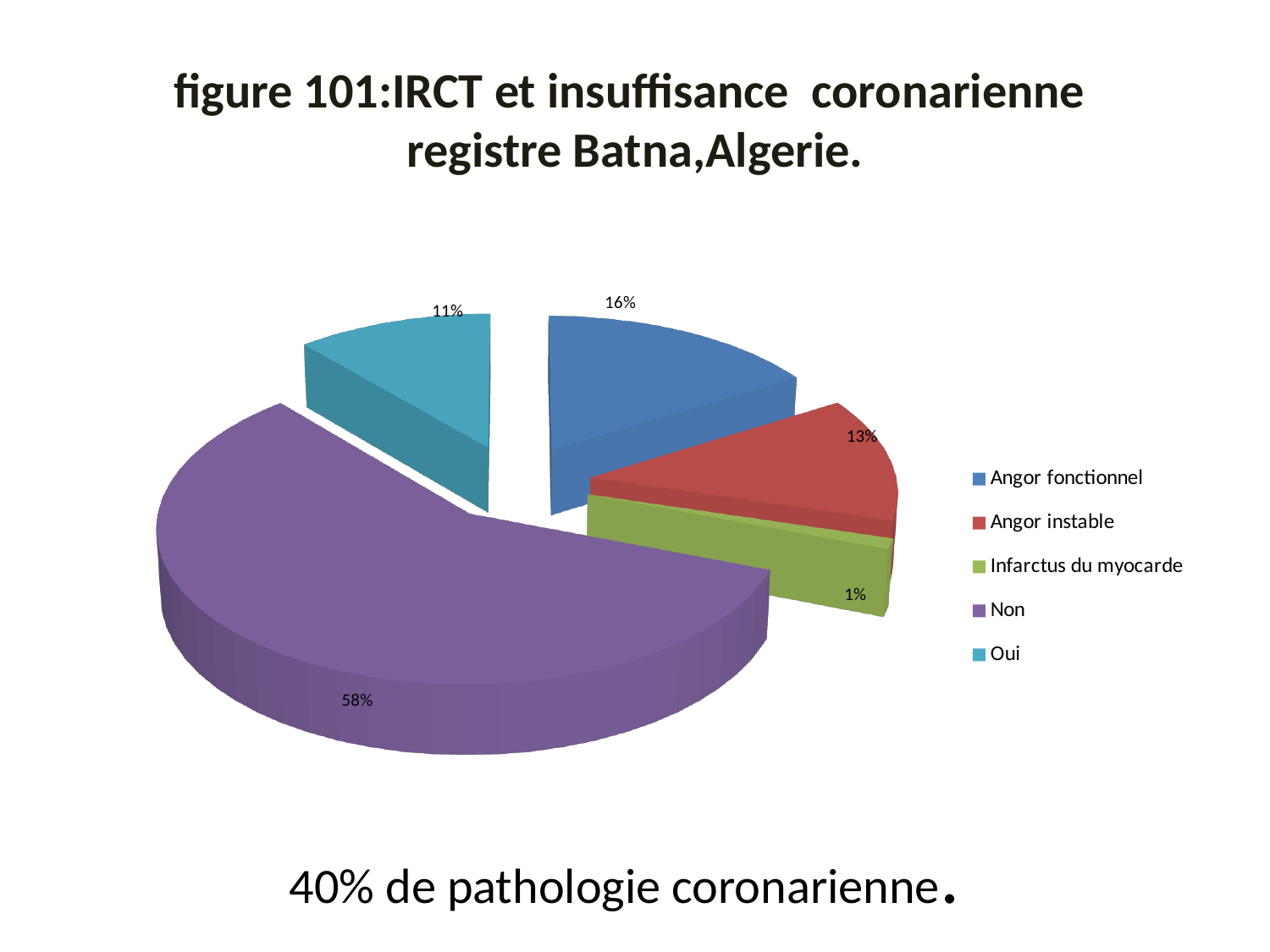
What percentage is shown for Angor instable? 13% What percentage is shown for Oui? 11% How many categories does the legend list? 5 What is the difference in percentage points between Non and Angor fonctionnel? 42 What percentage is shown for Angor fonctionnel? 16% Which category has the smallest slice of the pie? Infarctus du myocarde Which is larger, the Angor fonctionnel slice or the Oui slice? Angor fonctionnel Which category has the largest slice of the pie? Non What percentage of the pie does the Non slice represent? 58% What colour is the Non slice? Purple What percentage is shown for Infarctus du myocarde? 1% What kind of chart is shown on the slide? Pie chart